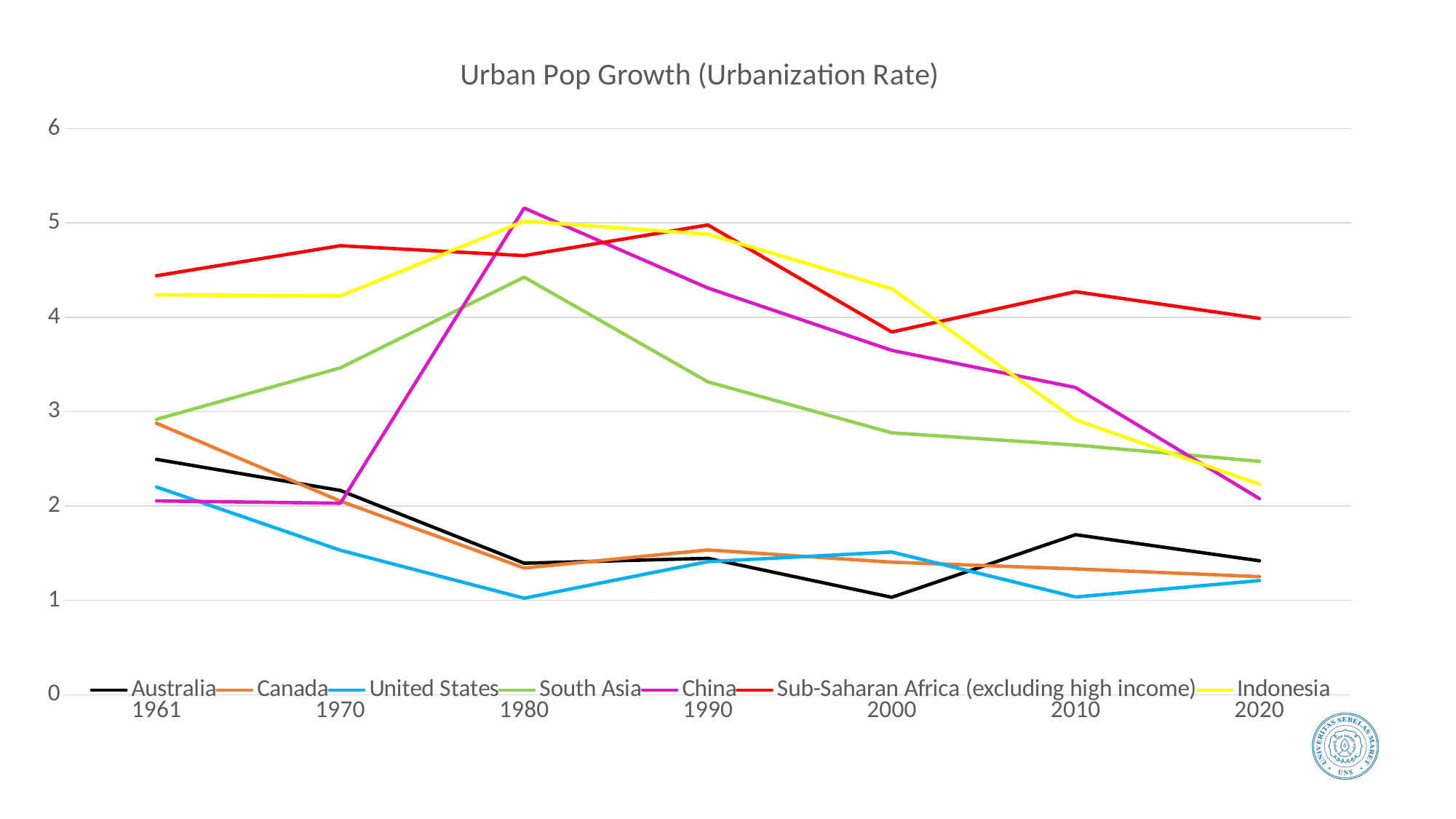
Is the value for Indonesia in 2020 greater or less than 3? less Is the value for South Asia in 1980 greater or less than 4? greater Which series has the lowest value in 2000? Australia How many years are shown along the x axis? 7 Does the South Asia line rise or fall from 1980 to 2020? fall How many series does the legend list? 7 What is the title of the chart? Urban Pop Growth (Urbanization Rate) Which series is drawn in red? Sub-Saharan Africa (excluding high income) What kind of chart is shown on the slide? line chart Which series has the highest value in 2020? Sub-Saharan Africa (excluding high income) In 1990, which is larger: the value for Sub-Saharan Africa (excluding high income) or the value for South Asia? Sub-Saharan Africa (excluding high income) Is the value for United States in 1980 greater or less than 2? less